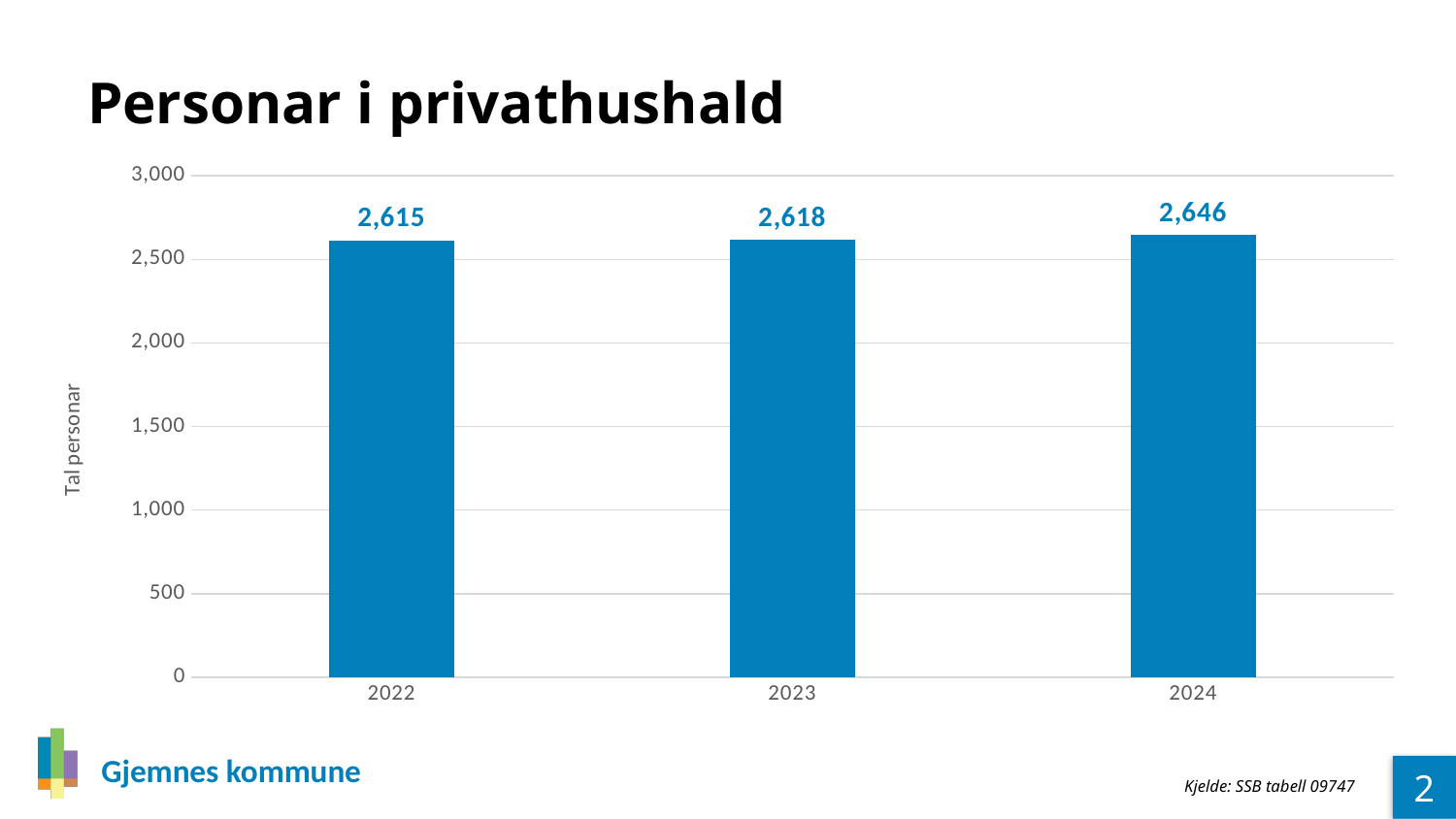
Do the values rise or fall from 2022 to 2024? rise Which year has the lowest value? 2022 Which year has the highest value? 2024 What is the value for 2024? 2,646 What is the difference between the values for 2024 and 2022? 31 Is the value for 2023 greater or less than 2,500? greater What is the difference between the values for 2024 and 2023? 28 Which is larger, the value for 2024 or the value for 2022? 2024 What is the value for 2023? 2,618 How many years are shown on the x axis? 3 What kind of chart is shown on the slide? bar chart What is the value for 2022? 2,615